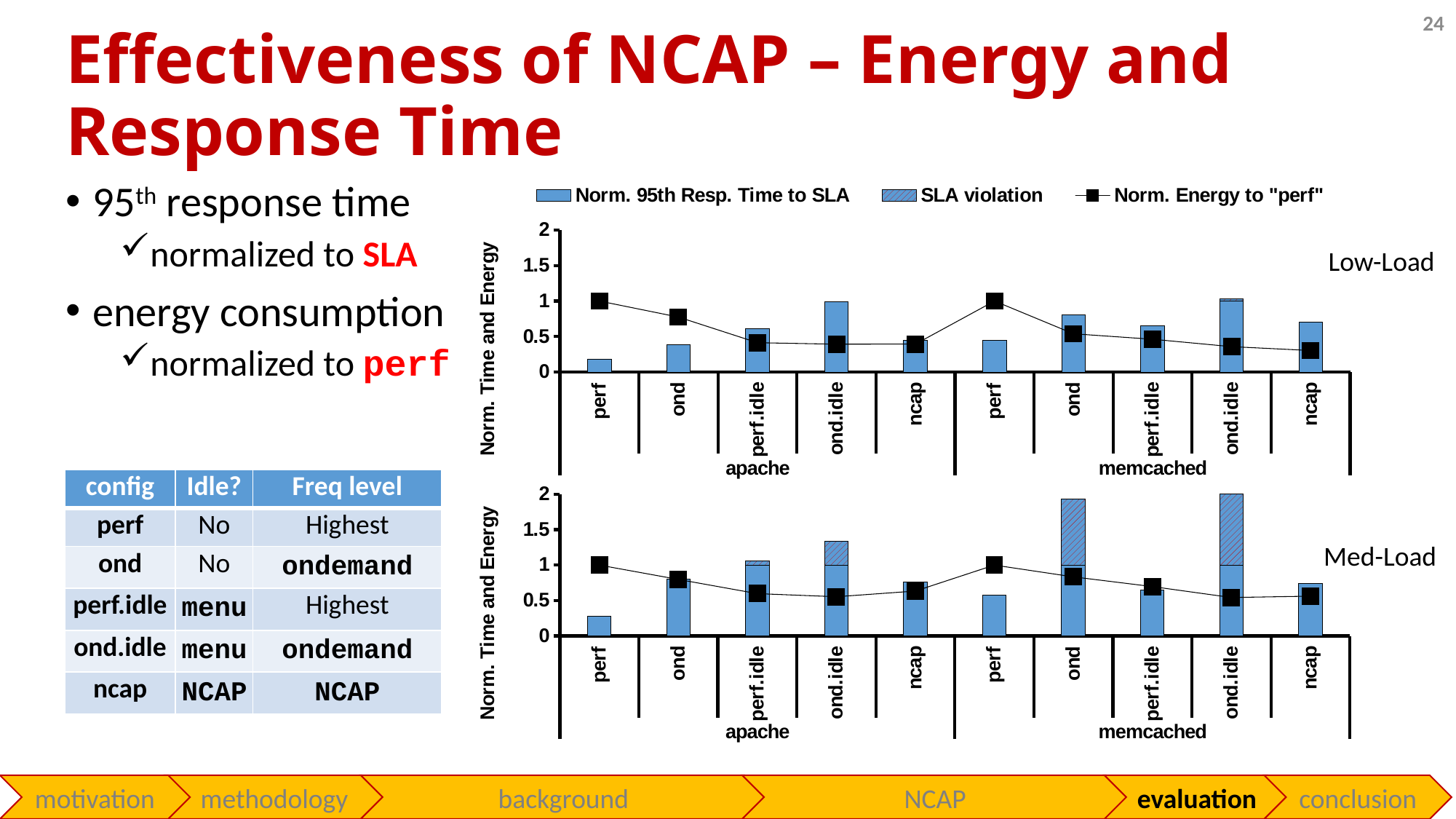
What kind of chart is the Med-Load chart? Bar chart with a line series In the Low-Load chart, what is the normalized energy value for apache perf? 1 In the Low-Load chart, is the normalized 95th response time for apache perf greater or less than 0.5? less How many series does the legend list for the charts? 3 In the Low-Load chart, which has the larger normalized 95th response time for apache: ond or ond.idle? ond.idle In the Low-Load chart, how many configuration bars are plotted in total across apache and memcached? 10 In the Low-Load chart, is the normalized 95th response time for memcached ncap greater or less than 0.5? greater In the Med-Load chart, which configuration has the lowest normalized 95th response time? apache perf In the Low-Load chart, which configuration has the lowest normalized 95th response time? apache perf What is the y-axis label of the Med-Load chart? Norm. Time and Energy